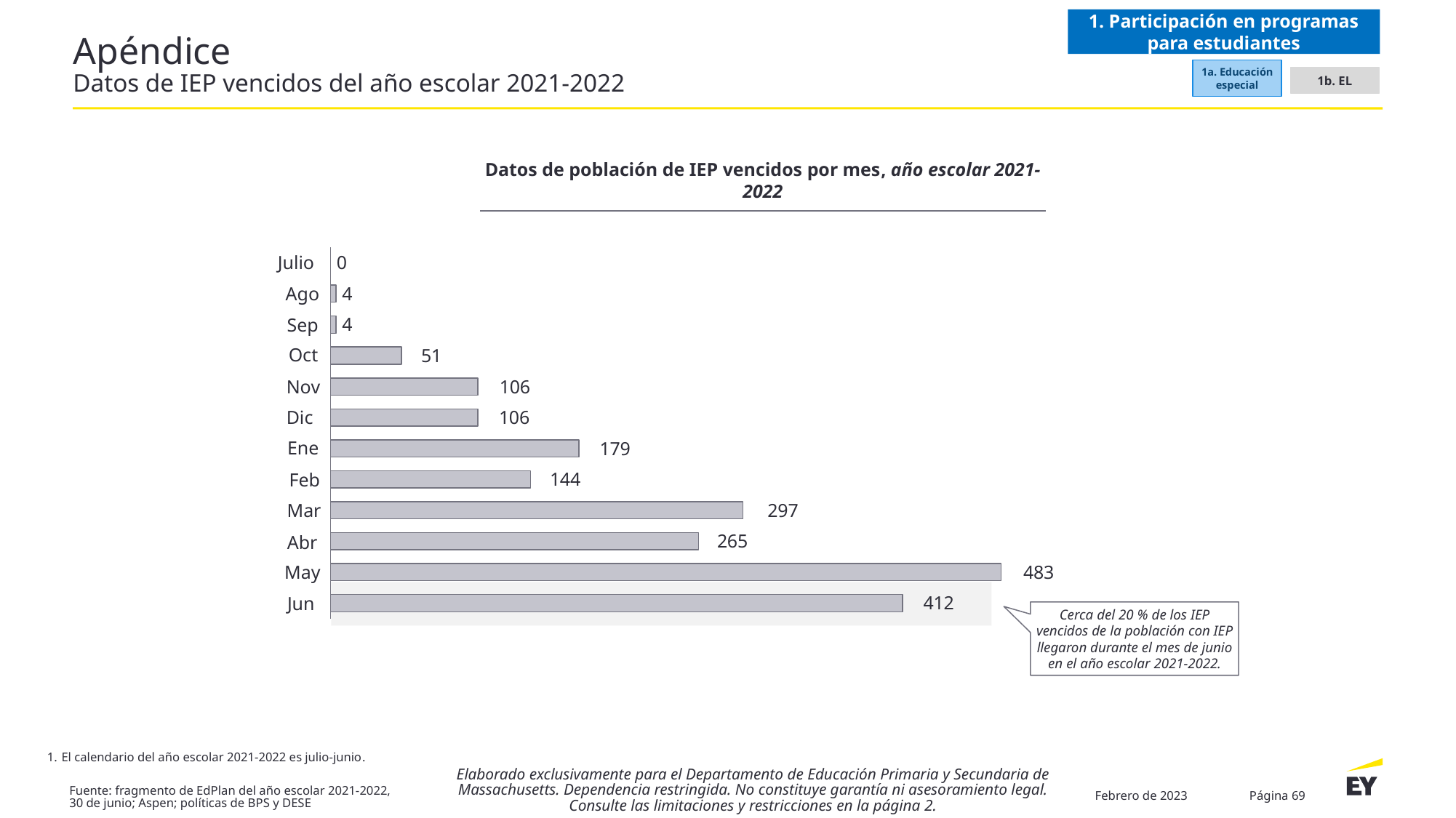
What is the difference between the values for May and Jun? 71 What is the title of the chart? Datos de población de IEP vencidos por mes, año escolar 2021-2022 What is the difference between the values for Mar and Abr? 32 Do the values generally rise or fall from Julio to May? Rise Which month has the highest value? May Which is larger, the value for Ene or the value for Feb? Ene What is the value for Ene? 179 What is the value for May? 483 Which month has the lowest value? Julio What kind of chart is shown on the slide? Bar chart What is the value for Oct? 51 How many months are shown in the chart? 12